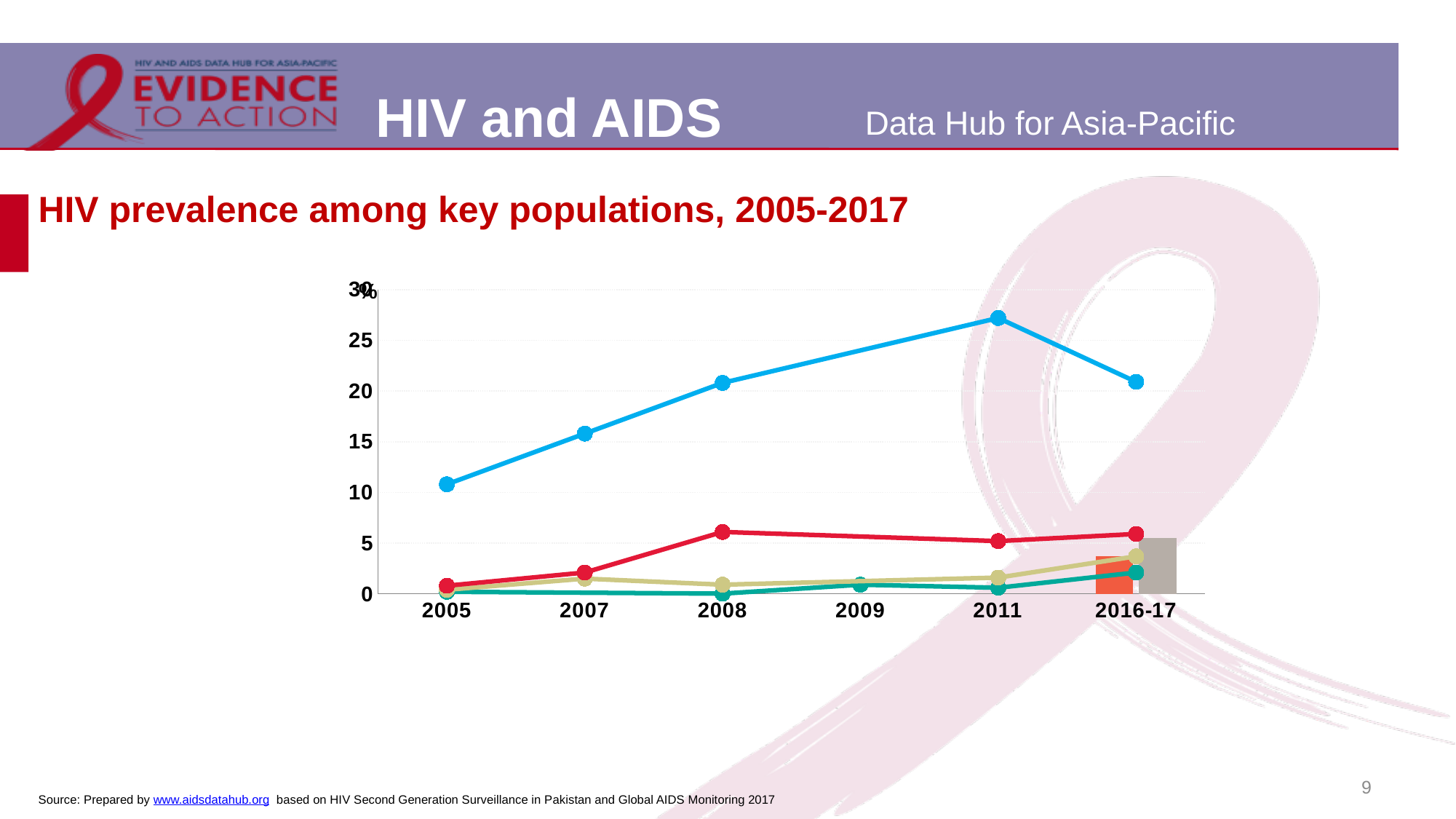
What is the title of the chart on the slide? HIV prevalence among key populations, 2005-2017 Is the value of the red line in 2008 greater or less than 5? greater How many time points are labelled on the x axis of the chart? 6 In which year does the blue line reach its highest value? 2011 Does the blue line rise or fall between 2005 and 2011? Rises Is the value of the blue line in 2011 greater or less than 25? greater What is the last category labelled on the x axis of the chart? 2016-17 Does the blue line rise or fall between 2011 and 2016-17? Falls Is the value of the blue line in 2005 greater or less than 15? less Which line has the higher value in 2008, the blue line or the red line? Blue line What kind of chart is shown on the slide? Combination bar and line chart